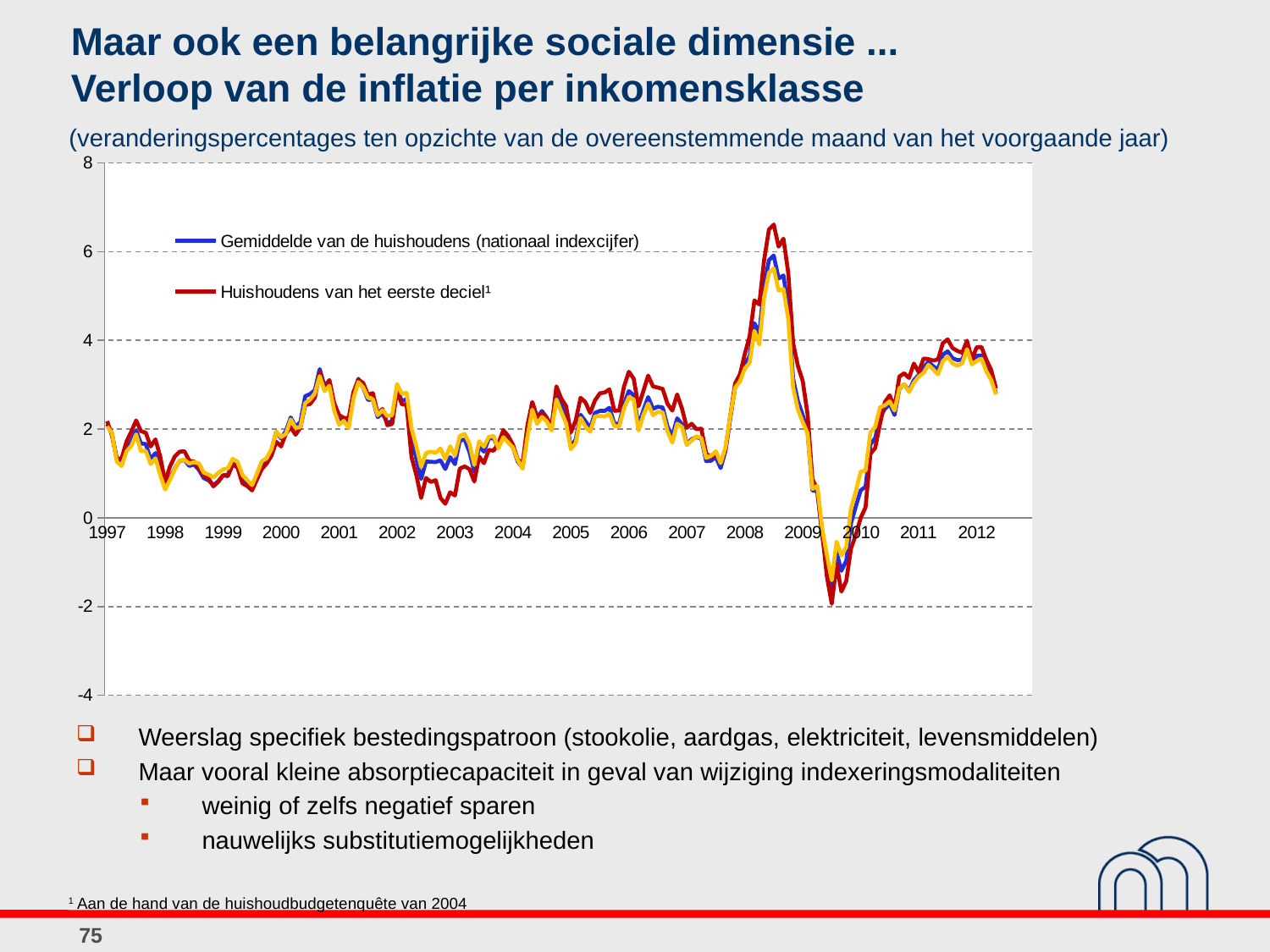
Is the lowest value of the 'Gemiddelde van de huishoudens' line in 2009 greater or less than 0? less How many year labels are shown on the horizontal axis? 16 In which year do the lines reach their lowest point? 2009 What is the highest value shown on the vertical axis? 8 Is the value of the 'Huishoudens van het eerste deciel' line in early 2003 greater or less than 2? less Is the peak value of the 'Huishoudens van het eerste deciel' line in 2008 greater or less than 6? greater In which year do the lines reach their highest peak? 2008 How many series does the legend list? 2 What colour is the line for 'Huishoudens van het eerste deciel' in the legend? red What kind of chart is shown on the slide? line chart Do the lines rise or fall from the trough in 2009 to 2011? rise